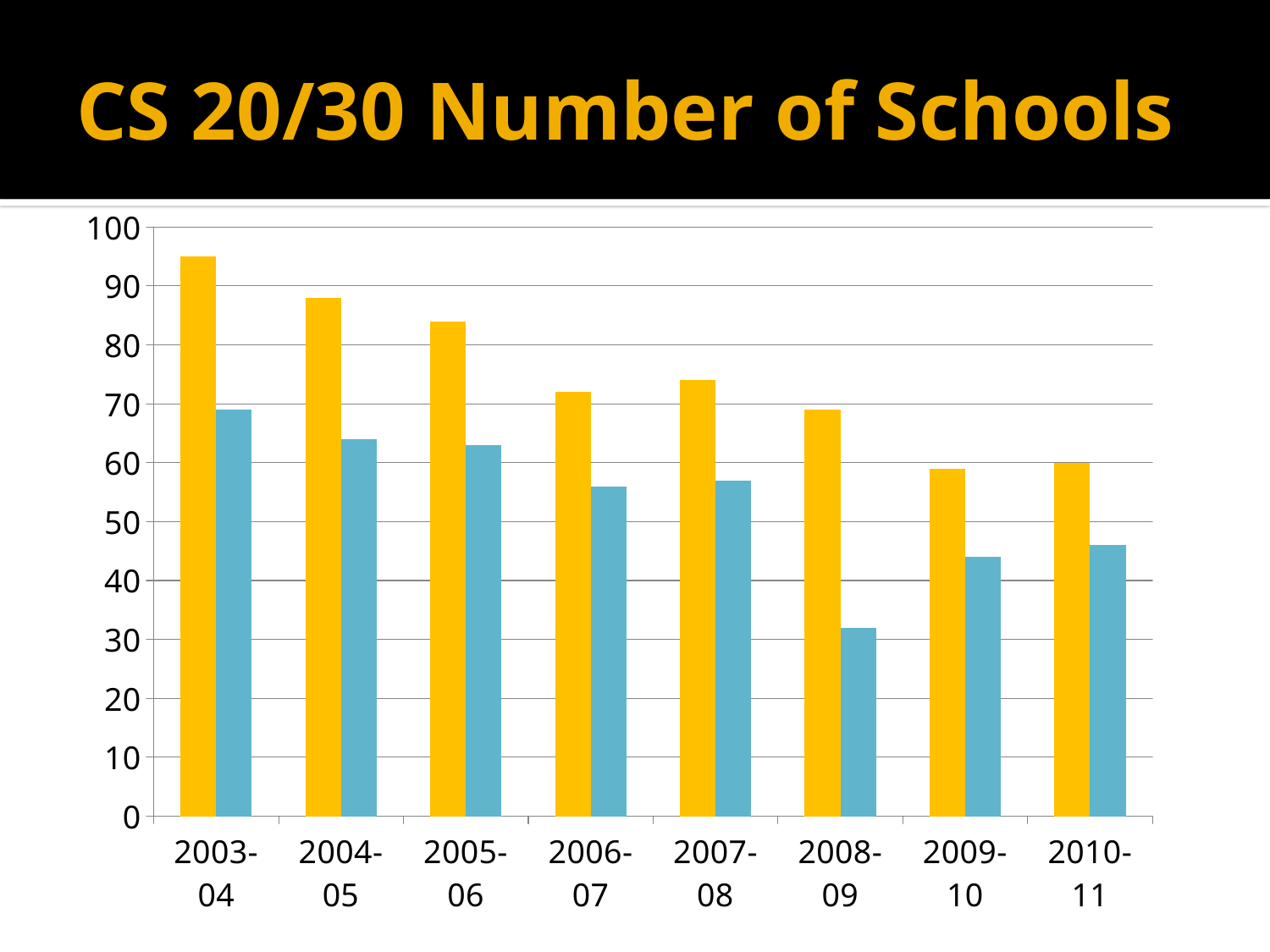
In which school year is the yellow bar highest? 2003-04 Is the yellow bar for 2003-04 greater or less than 90? greater What kind of chart is shown on the slide? bar chart What is the title of the chart? CS 20/30 Number of Schools In which school year is the blue bar lowest? 2008-09 How many bars are plotted for each school year? 2 Is the blue bar for 2008-09 greater or less than 40? less How many school-year categories are shown on the x axis? 8 Do the yellow bars generally rise or fall from 2003-04 to 2010-11? fall In which school year is the blue bar highest? 2003-04 In 2003-04, which bar is taller, the yellow bar or the blue bar? yellow Is the yellow bar for 2006-07 greater or less than 80? less